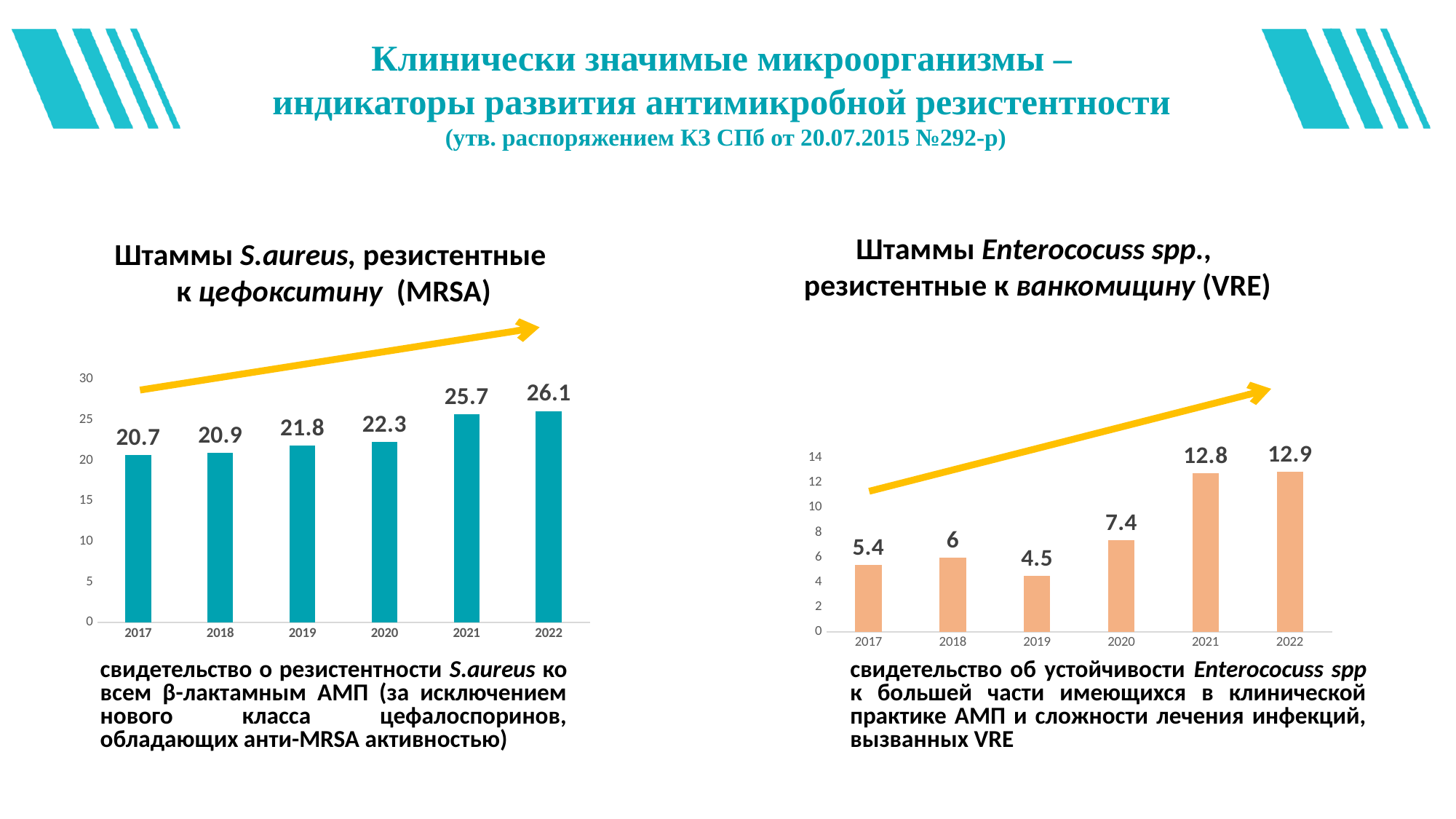
In the right chart (VRE), which year has the lowest value? 2019 What kind of chart is the right chart (VRE)? bar chart In the left chart (MRSA), which year has the highest value? 2022 In the left chart (MRSA), what is the value for 2019? 21.8 In the left chart (MRSA), is the value for 2021 greater or less than 25? greater In the right chart (VRE), what is the difference between the 2021 and 2020 values? 5.4 In the left chart (MRSA), do the values generally rise or fall from 2017 to 2022? rise In the left chart (MRSA), what is the difference between the 2022 and 2017 values? 5.4 How many years are shown on the x axis of the left chart (MRSA)? 6 In the right chart (VRE), which year has the larger value, 2018 or 2019? 2018 What colour are the bars in the right chart (VRE)? orange In the right chart (VRE), what is the value for 2020? 7.4